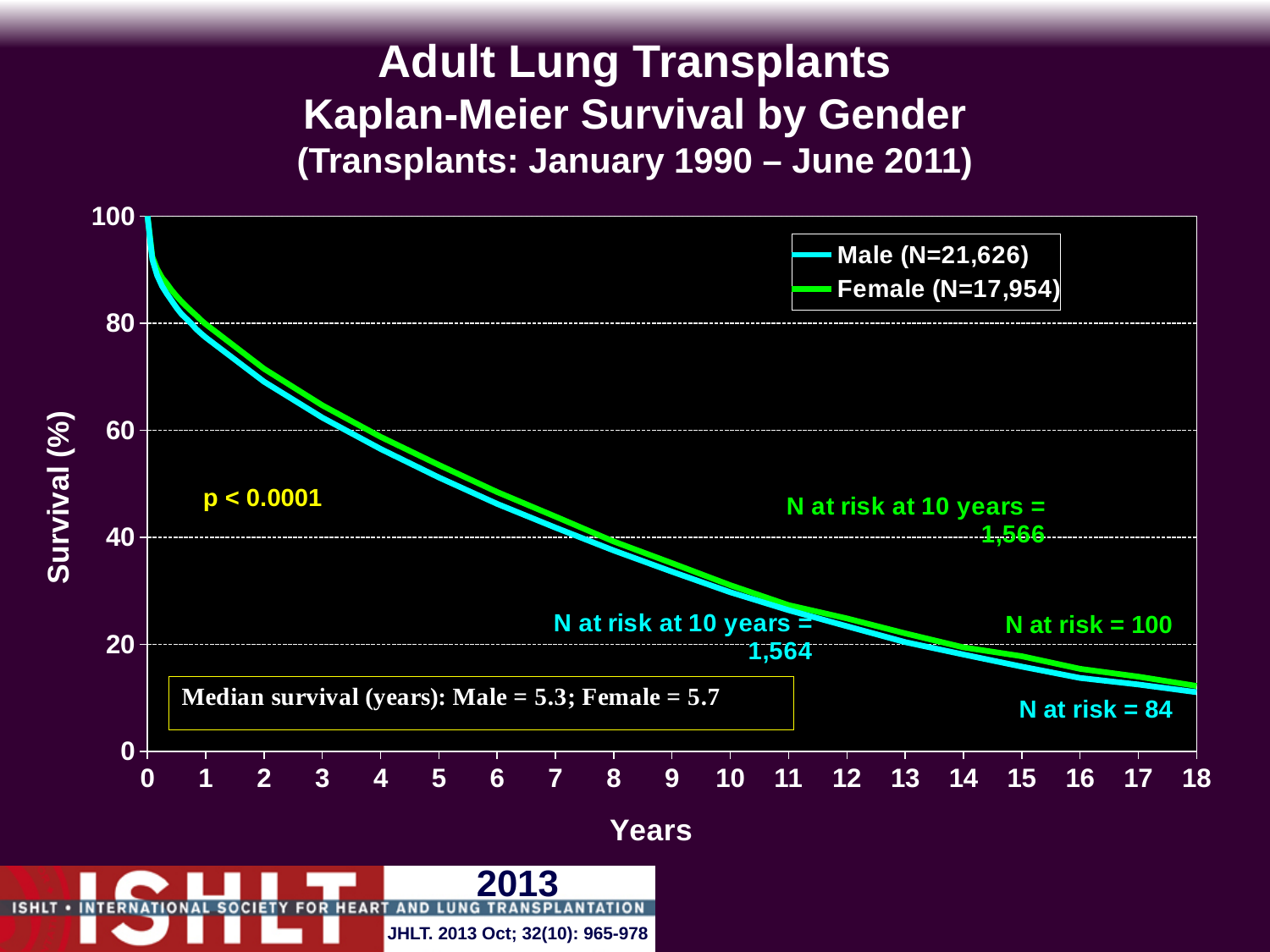
What type of chart is shown on the slide? line chart What is the number of males at risk at 10 years? 1,564 What is the N for the Male group shown in the legend? 21,626 What is the median survival in years for males? 5.3 What is the number of females at risk at 10 years? 1,566 Do the survival curves rise or fall as years increase? fall What is the median survival in years for females? 5.7 Is the Male survival at 5 years greater or less than 60%? less What is the N for the Female group shown in the legend? 17,954 What is the difference in median survival (years) between females and males? 0.4 How many series does the legend list? 2 Which gender has the longer median survival? Female